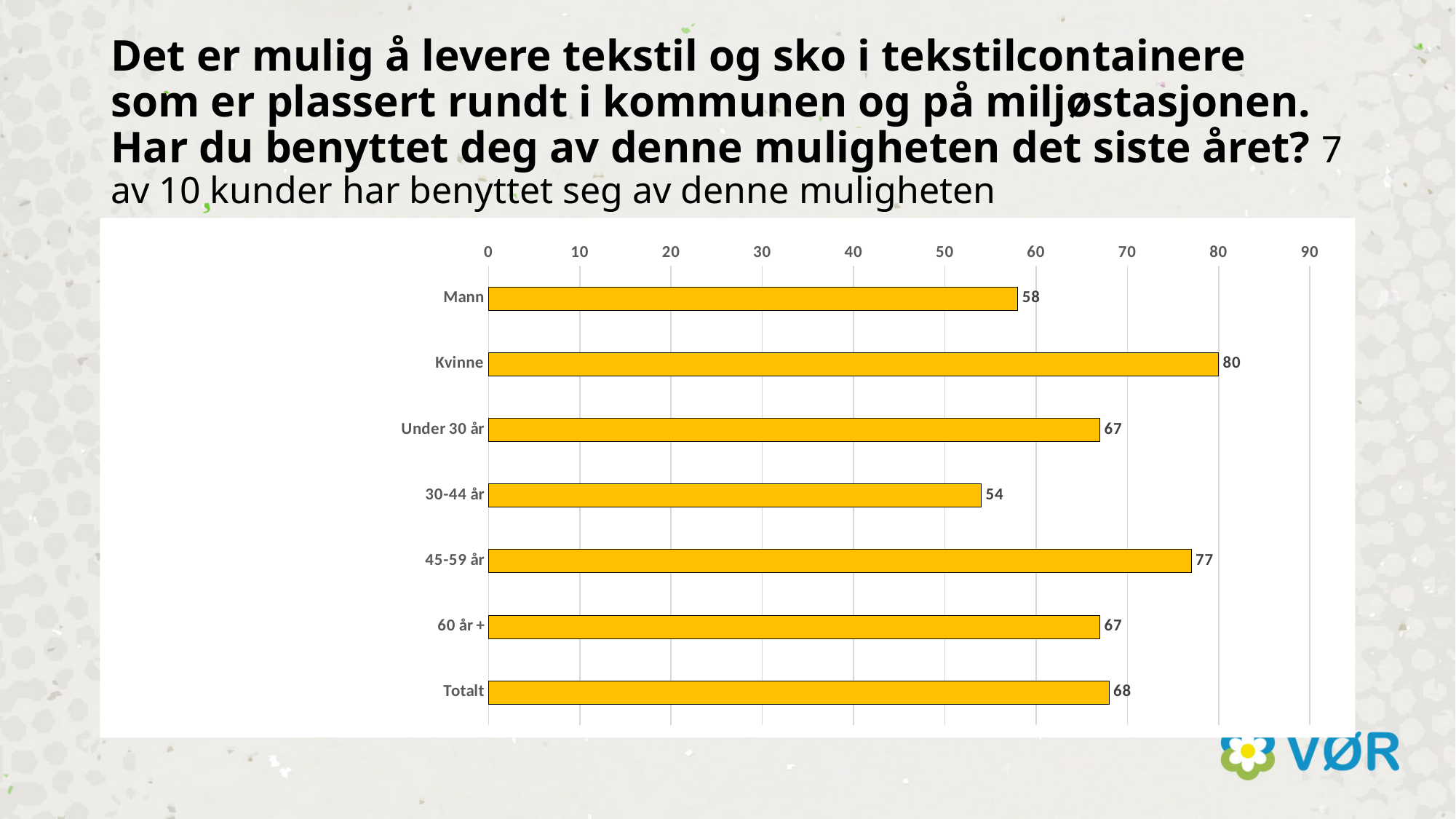
What colour are the bars in the chart? yellow Which category has the lowest value? 30-44 år What is the value for Totalt? 68 Which is larger, the value for 45-59 år or the value for 60 år +? 45-59 år What kind of chart is shown on the slide? bar chart Which category has the highest value? Kvinne What is the difference between the values for Kvinne and Mann? 22 Is the value for 30-44 år greater or less than 60? less How many categories are shown in the chart? 7 What is the value for Kvinne? 80 What is the value for 30-44 år? 54 What is the value for Mann? 58